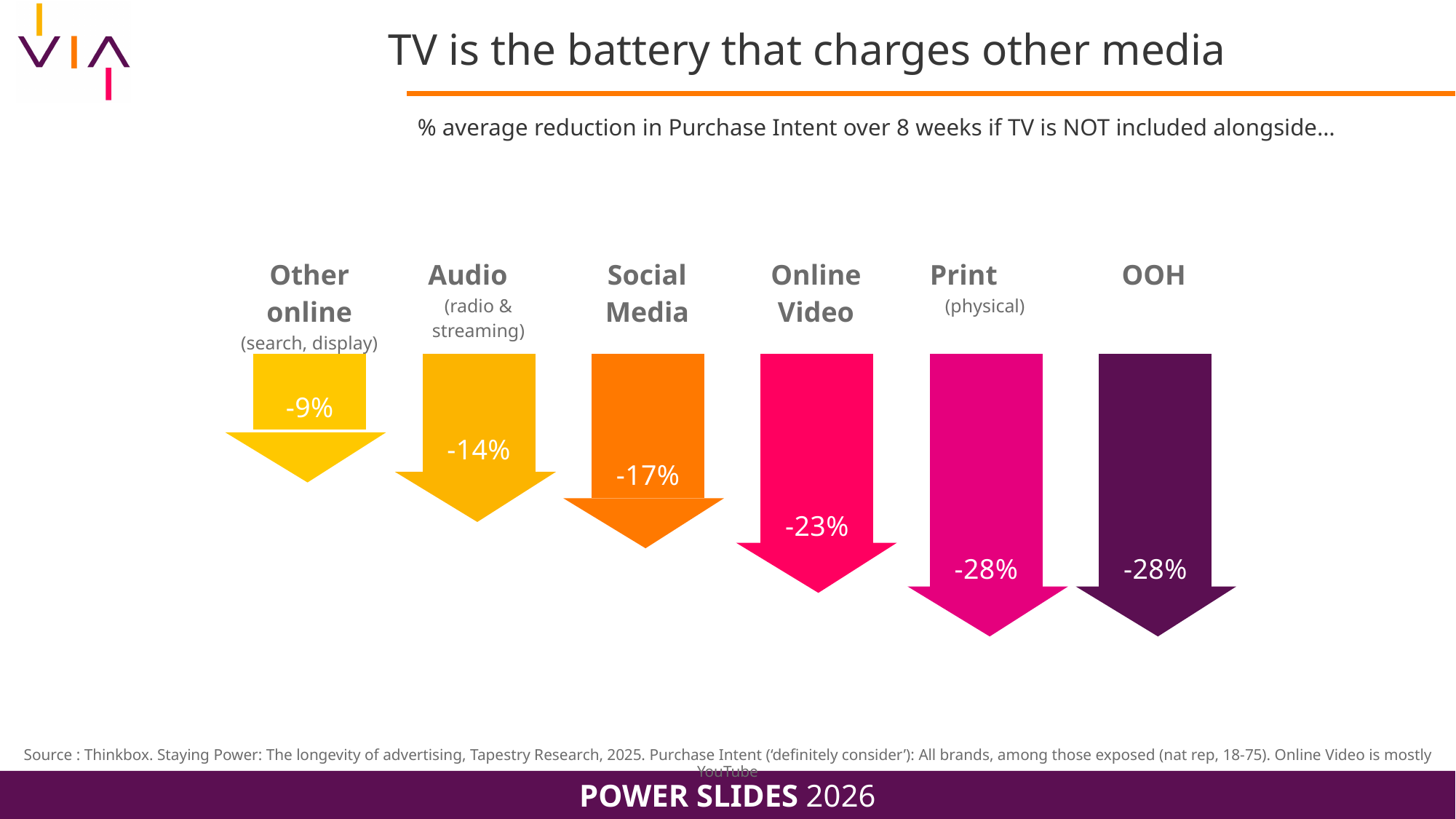
Which shows a larger reduction in Purchase Intent, Social Media or Online Video? Online Video What reduction in Purchase Intent is shown for Online Video? -23% Do the reductions get larger or smaller moving from left to right across the chart? Larger How many media categories are shown in the chart? 6 By how many percentage points does the reduction for Online Video exceed that for Audio? 9 percentage points What is the average reduction in Purchase Intent shown for Other online (search, display)? -9% What is the value shown for Social Media? -17% Which two categories share the largest reduction of -28%? Print and OOH Which category shows the smallest reduction in Purchase Intent? Other online What value is shown for Audio (radio & streaming)? -14% What value is shown for OOH? -28% What value is shown for Print (physical)? -28%